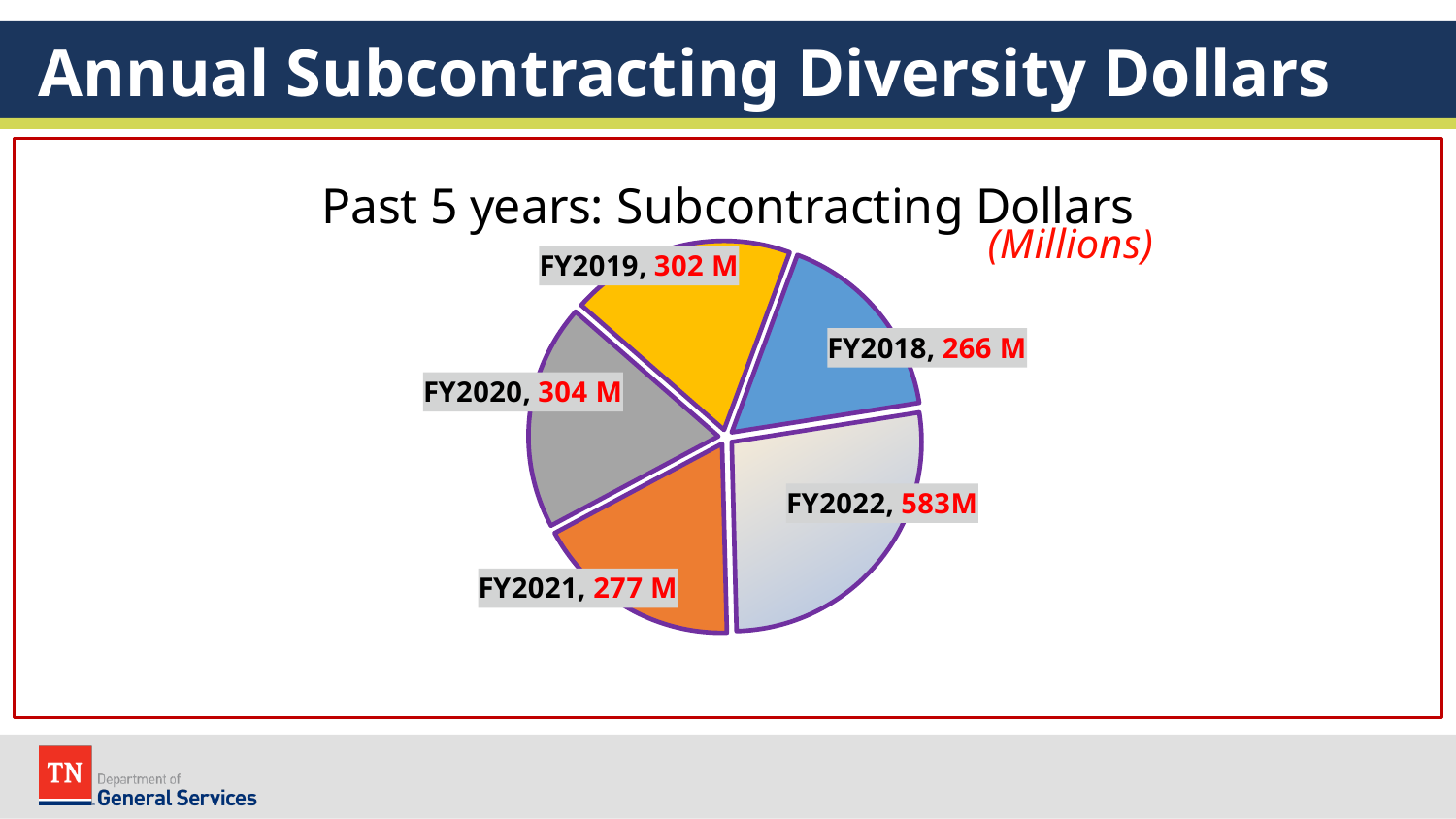
What is the value for FY2022 in the pie chart? 583M How many fiscal years are shown in the pie chart? 5 Which fiscal year has the smallest slice in the pie chart? FY2018 What kind of chart is shown on the slide? Pie chart What is the value for FY2020 in the pie chart? 304 M What is the title of the chart on the slide? Past 5 years: Subcontracting Dollars What is the value for FY2021 in the pie chart? 277 M Which fiscal year has the largest slice in the pie chart? FY2022 What is the difference between the FY2021 value and the FY2018 value? 11 M What is the value for FY2018 in the pie chart? 266 M What is the difference between the FY2022 value and the FY2018 value? 317 M Which is larger, the value for FY2021 or the value for FY2018? FY2021